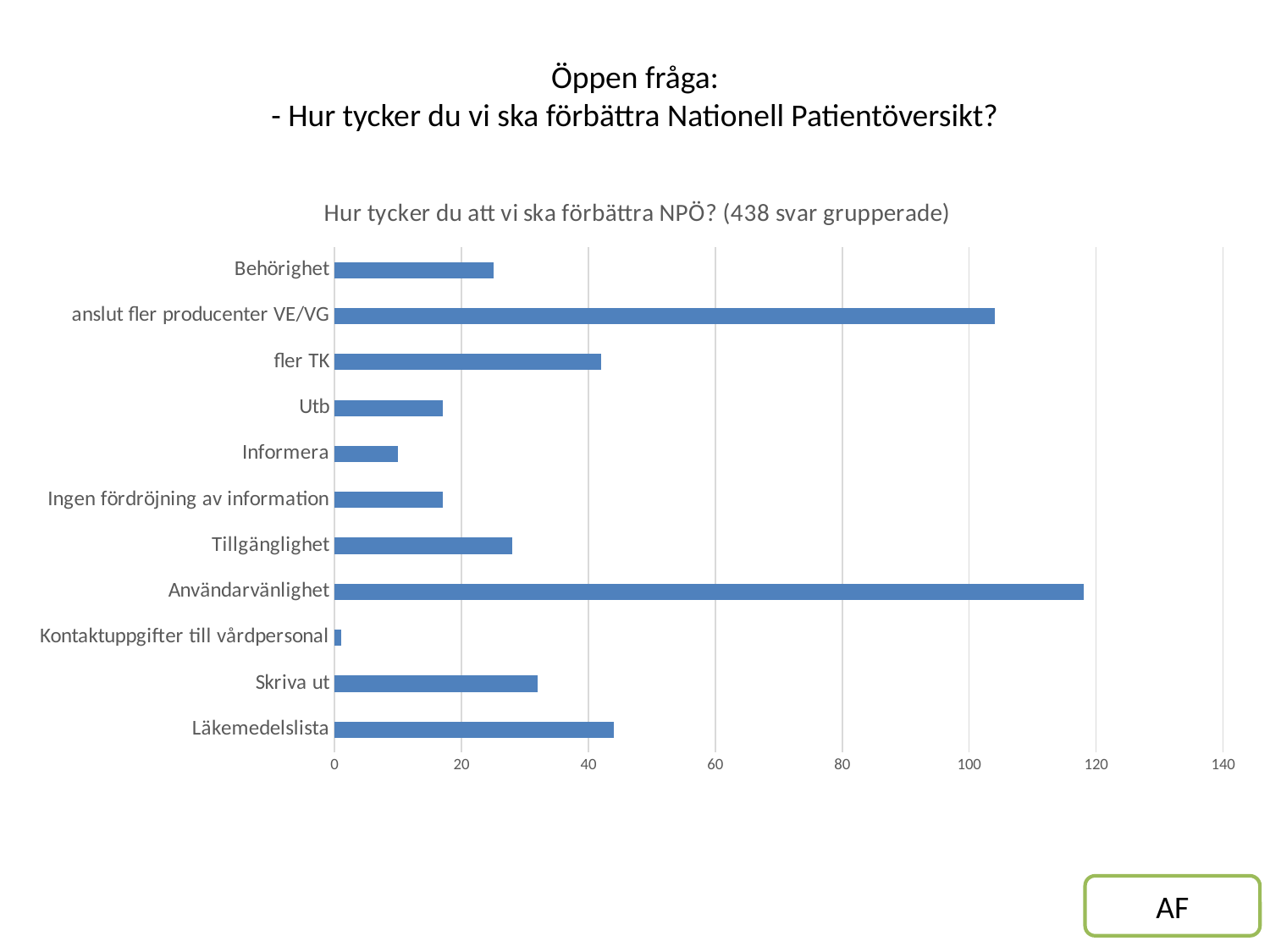
How many categories are shown in the chart? 11 Which is larger, the value for Behörighet or the value for Informera? Behörighet Which category has the lowest value? Kontaktuppgifter till vårdpersonal Is the value for Behörighet greater or less than 20? greater According to the chart title, how many responses were grouped? 438 Which category has the highest value? Användarvänlighet Is the value for Användarvänlighet greater or less than 100? greater Is the value for Informera greater or less than 20? less Which is larger, the value for anslut fler producenter VE/VG or the value for fler TK? anslut fler producenter VE/VG What kind of chart is shown on the slide? bar chart